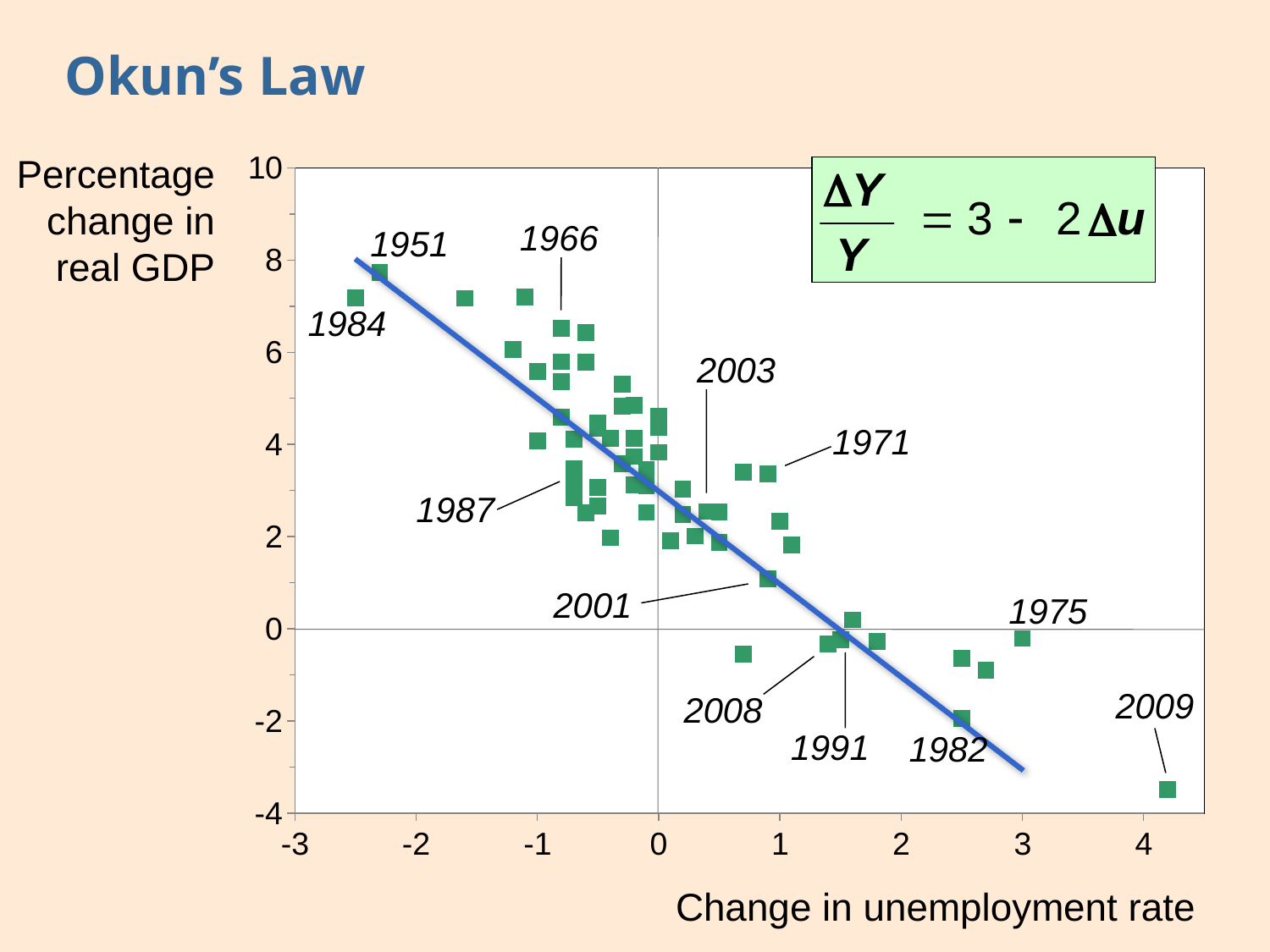
Which labelled point has a larger change in unemployment rate, 1975 or 1987? 1975 Is the percentage change in real GDP for the point labelled 2001 greater or less than 2? less As the change in unemployment rate increases along the x axis, does the percentage change in real GDP generally rise or fall? fall Is the change in unemployment rate for the point labelled 2009 greater or less than 4? greater What kind of chart is shown on the slide? scatter chart Is the change in unemployment rate for the point labelled 1984 greater or less than -2? less Among the labelled points, which year has the lowest percentage change in real GDP? 2009 What is the label of the x axis? Change in unemployment rate Which labelled point has a higher percentage change in real GDP, 1951 or 2009? 1951